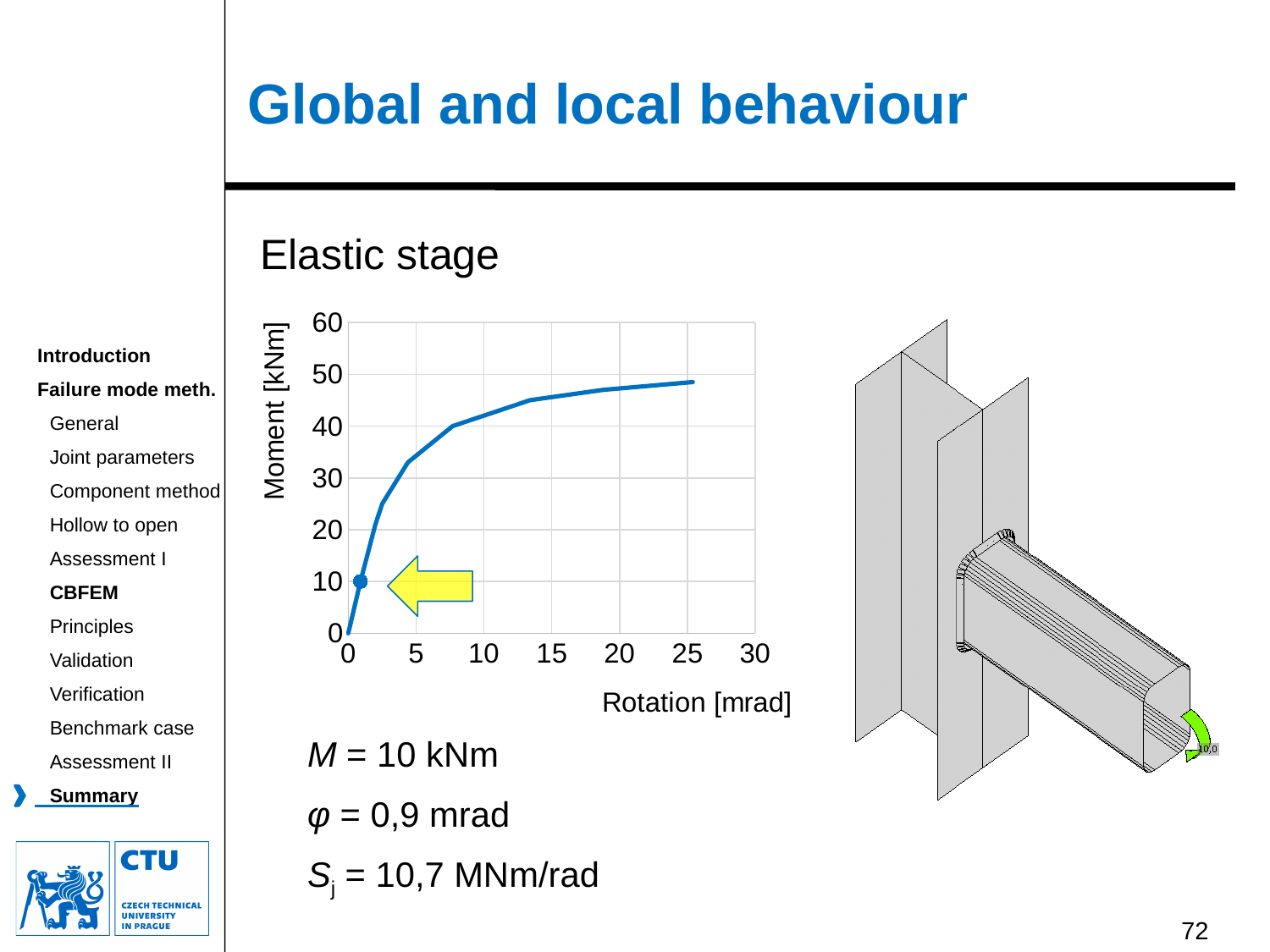
What rotation does the marked point on the curve correspond to, according to the slide? 0,9 mrad Does the moment rise or fall as the rotation increases along the x axis? rise Is the moment at a rotation of 25 mrad greater or less than 40 kNm? greater What is the label of the vertical axis of the chart? Moment [kNm] Is the moment at a rotation of 5 mrad greater or less than 40 kNm? less Is the moment at a rotation of 10 mrad greater or less than 30 kNm? greater What is the highest tick value shown on the vertical axis? 60 How many curves are plotted on the chart? 1 What moment value does the marked point on the curve correspond to, according to the slide? 10 kNm What is the label of the horizontal axis of the chart? Rotation [mrad] What is the highest tick value shown on the horizontal axis? 30 What kind of chart is shown on the slide? line chart